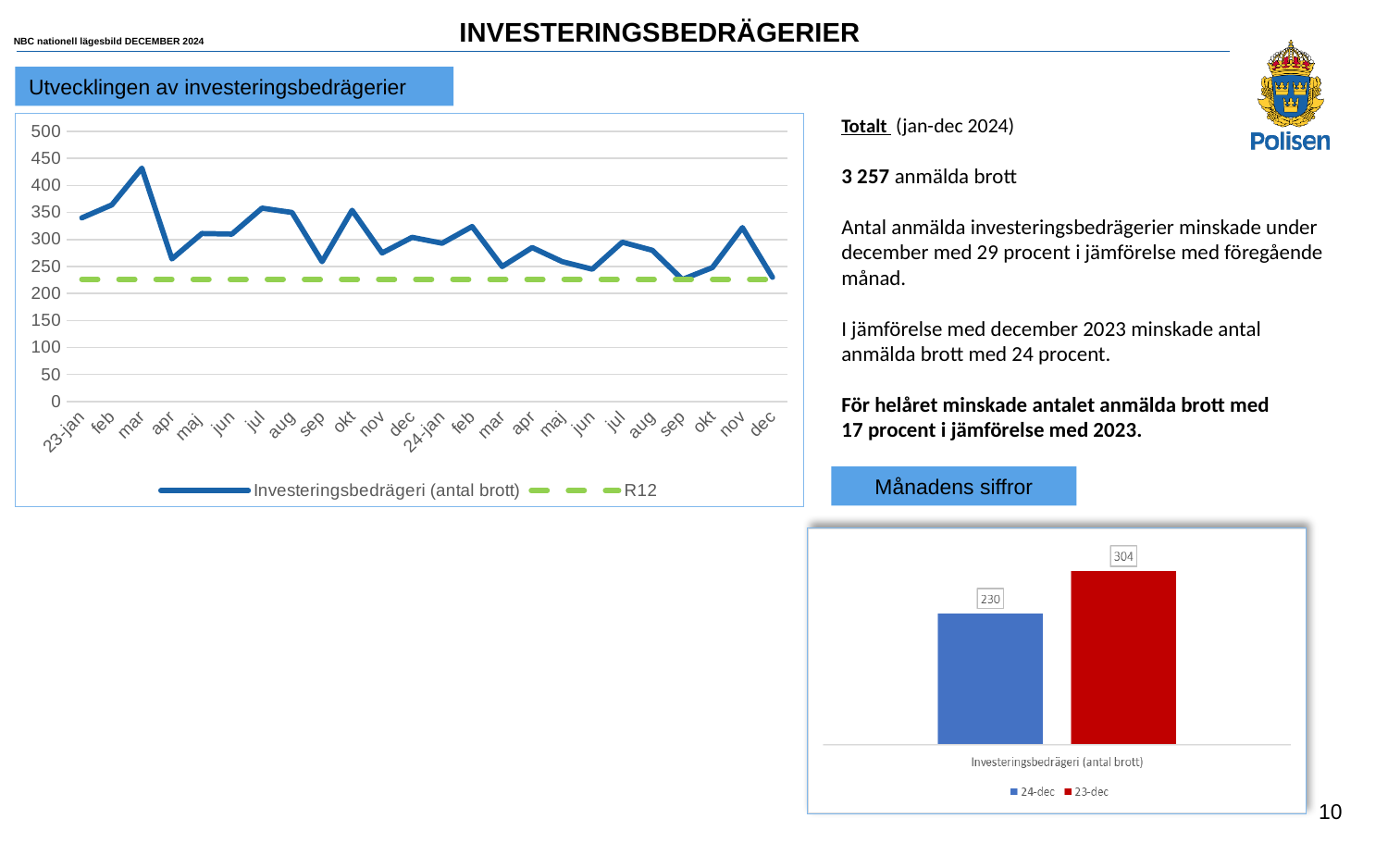
In the 'Utvecklingen av investeringsbedrägerier' chart, which month has the highest value for Investeringsbedrägeri (antal brott)? mar (2023) In the 'Utvecklingen av investeringsbedrägerier' chart, what are the two legend entries? Investeringsbedrägeri (antal brott) and R12 What kind of chart is the 'Månadens siffror' chart? Bar chart In the 'Utvecklingen av investeringsbedrägerier' chart, is the R12 line greater or less than 250? less In the 'Månadens siffror' bar chart, what is the value for 23-dec? 304 In the 'Utvecklingen av investeringsbedrägerier' chart, how many series does the legend list? 2 In the 'Utvecklingen av investeringsbedrägerier' chart, is the value for Investeringsbedrägeri (antal brott) in mar 2023 greater or less than 400? greater What kind of chart is the 'Utvecklingen av investeringsbedrägerier' chart? Line chart In the 'Månadens siffror' chart, how many series does the legend list? 2 In the 'Månadens siffror' bar chart, what is the difference between the 23-dec and 24-dec values? 74 In the 'Månadens siffror' bar chart, which is larger, 24-dec or 23-dec? 23-dec In the 'Månadens siffror' bar chart, what is the value for 24-dec? 230